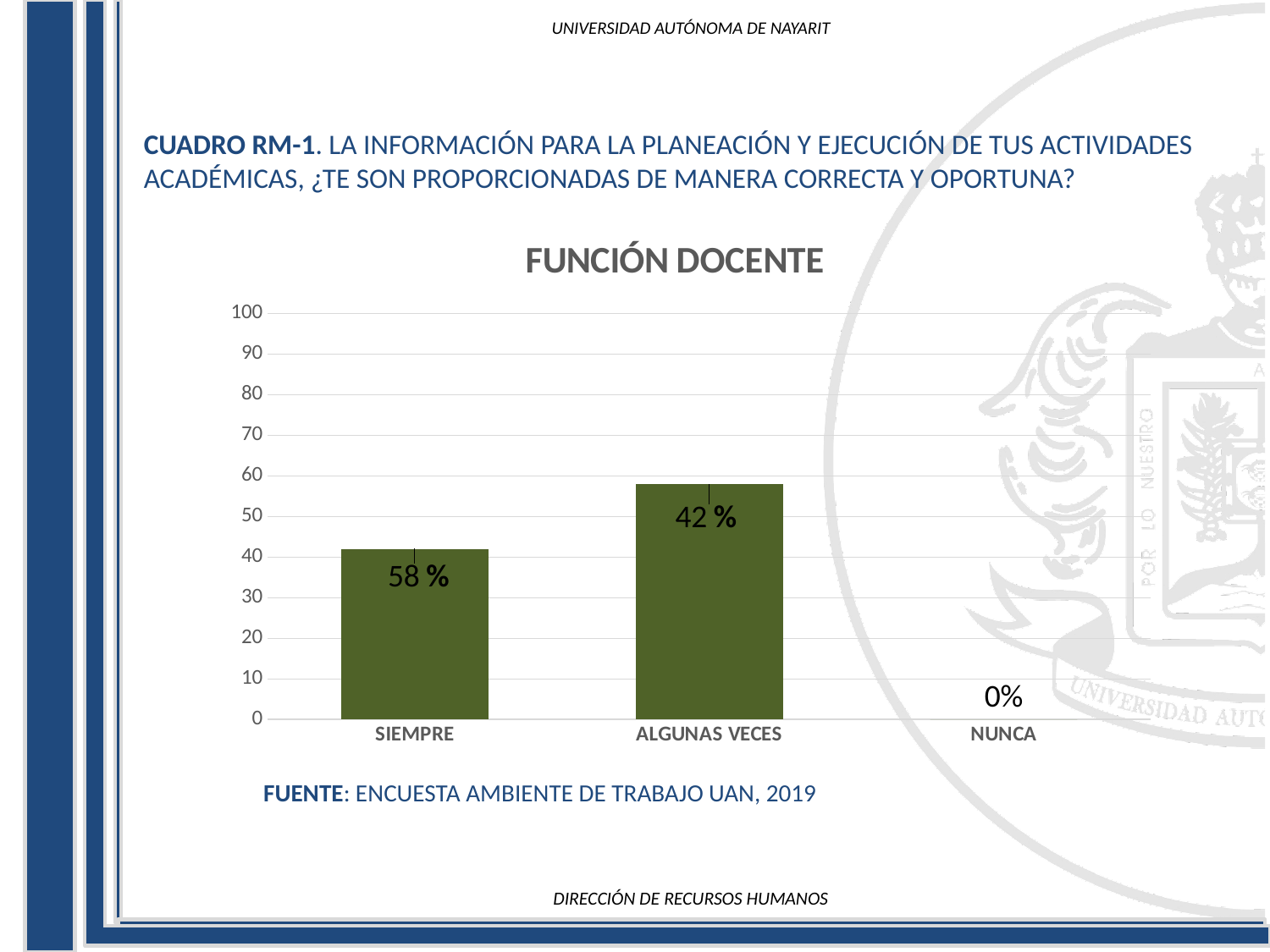
What is the highest value shown on the y axis of the FUNCIÓN DOCENTE chart? 100 What kind of chart is the FUNCIÓN DOCENTE chart? Bar chart What is the data label shown for ALGUNAS VECES in the FUNCIÓN DOCENTE chart? 42 % Is the value for NUNCA larger or smaller than the value for SIEMPRE? smaller What is the title of the chart on the slide? FUNCIÓN DOCENTE Which category has the lowest value in the FUNCIÓN DOCENTE chart? NUNCA How many categories are shown on the x axis of the FUNCIÓN DOCENTE chart? 3 Is the value for NUNCA greater or less than 10? less What is the data label shown for NUNCA in the FUNCIÓN DOCENTE chart? 0% What is the data label shown for SIEMPRE in the FUNCIÓN DOCENTE chart? 58 %